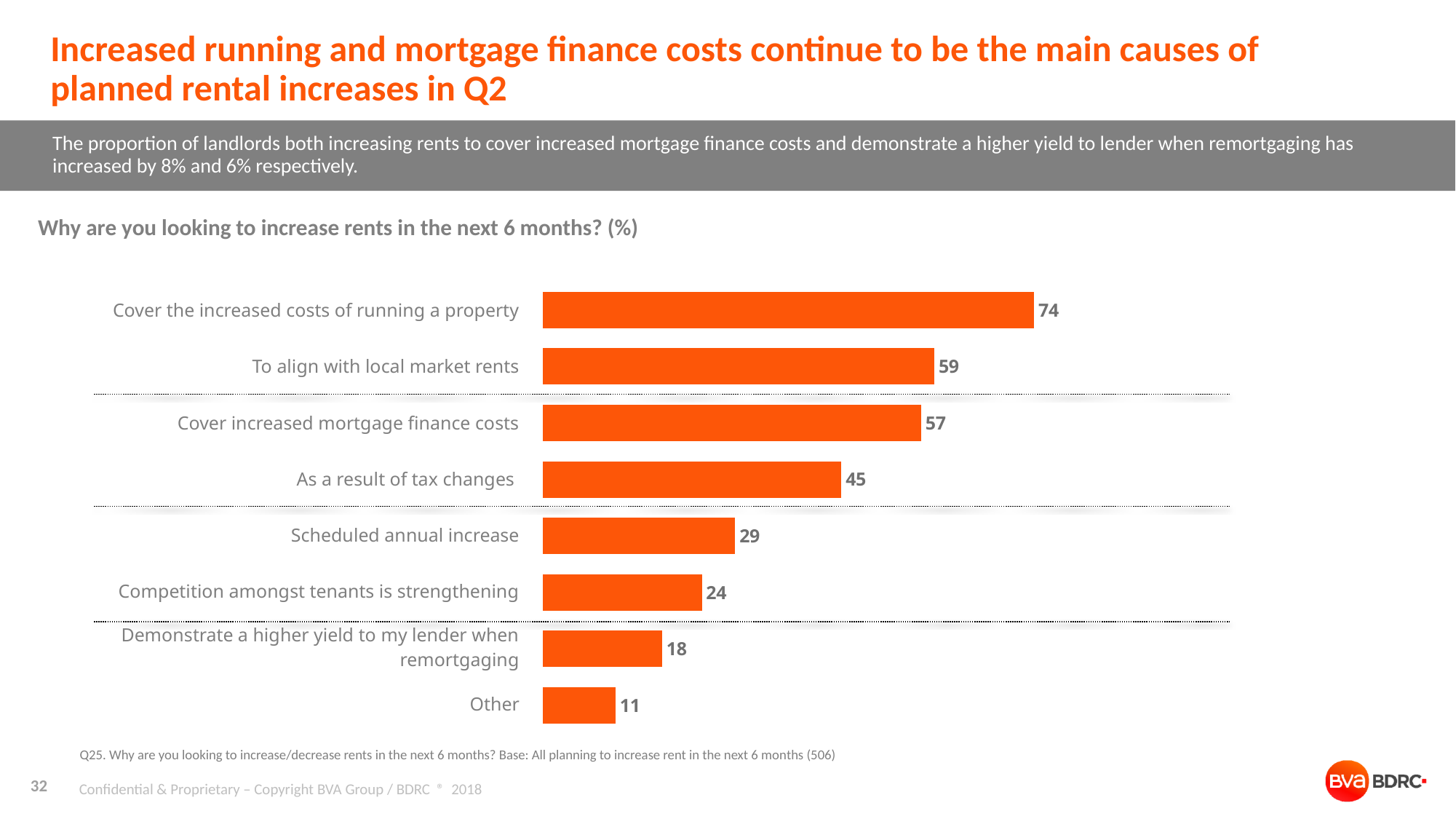
What is the value for "Scheduled annual increase"? 29 Which is larger: "Scheduled annual increase" or "Competition amongst tenants is strengthening"? Scheduled annual increase What kind of chart is shown on the slide? Bar chart Which category has the lowest value? Other What is the difference between "Cover the increased costs of running a property" and "Other"? 63 How many categories are shown in the chart? 8 What is the value for "As a result of tax changes"? 45 What is the value for "Cover the increased costs of running a property"? 74 Which category has the highest value? Cover the increased costs of running a property What is the difference between "To align with local market rents" and "Cover increased mortgage finance costs"? 2 What is the value for "Demonstrate a higher yield to my lender when remortgaging"? 18 What is the title of the chart? Why are you looking to increase rents in the next 6 months? (%)